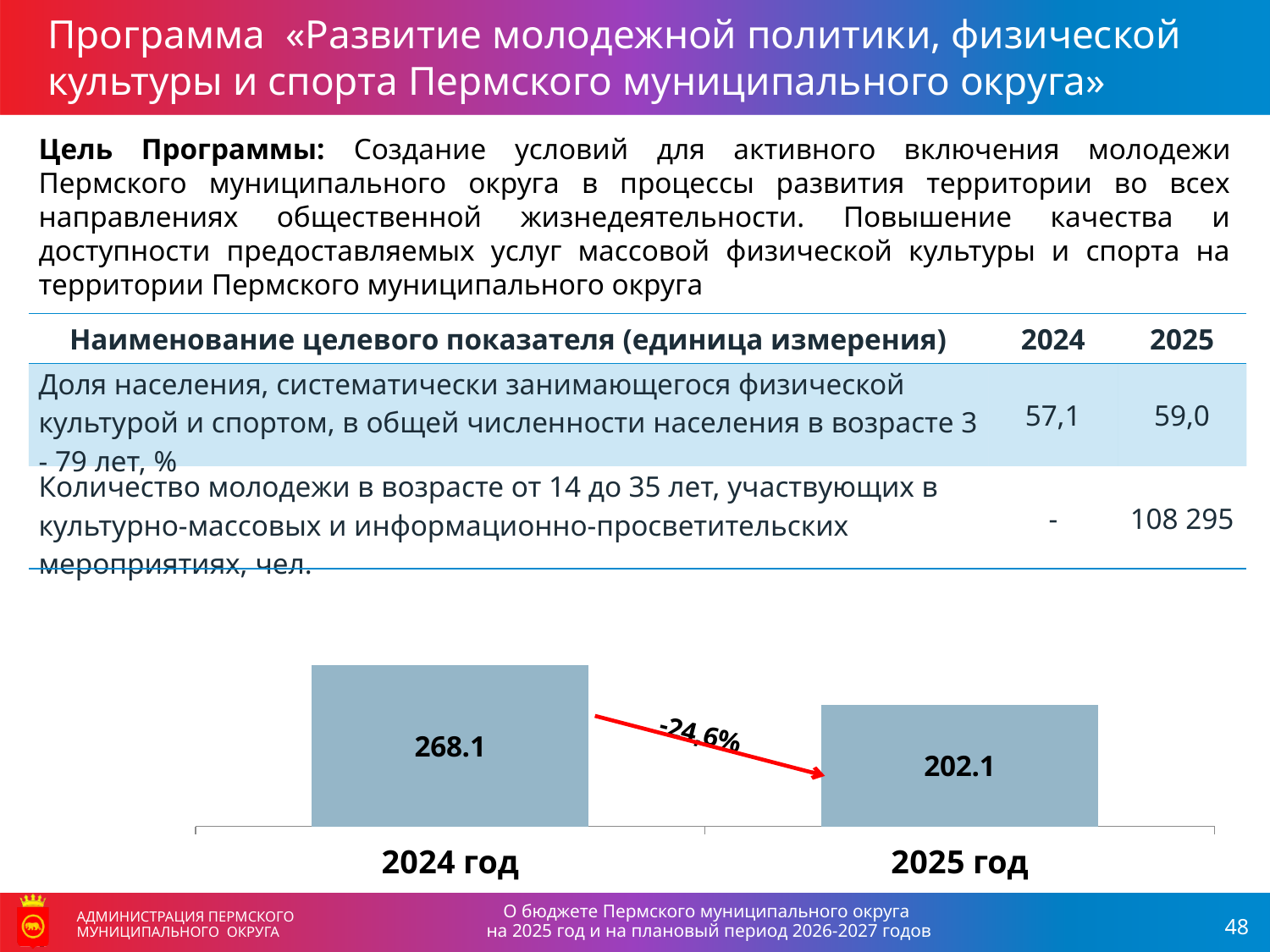
What kind of chart is shown at the bottom of the slide? bar chart How many categories are shown in the bar chart? 2 What is the value for 2024 год in the bar chart? 268.1 What is the difference between the values for 2024 год and 2025 год in the bar chart? 66.0 Do the values in the bar chart rise or fall from 2024 год to 2025 год? fall Which is larger in the bar chart, the value for 2024 год or the value for 2025 год? 2024 год What colour are the bars in the chart? blue-grey Which category has the lowest value in the bar chart? 2025 год Which category has the highest value in the bar chart? 2024 год What is the value for 2025 год in the bar chart? 202.1 What percentage change is written on the red arrow between the two bars in the chart? -24.6%